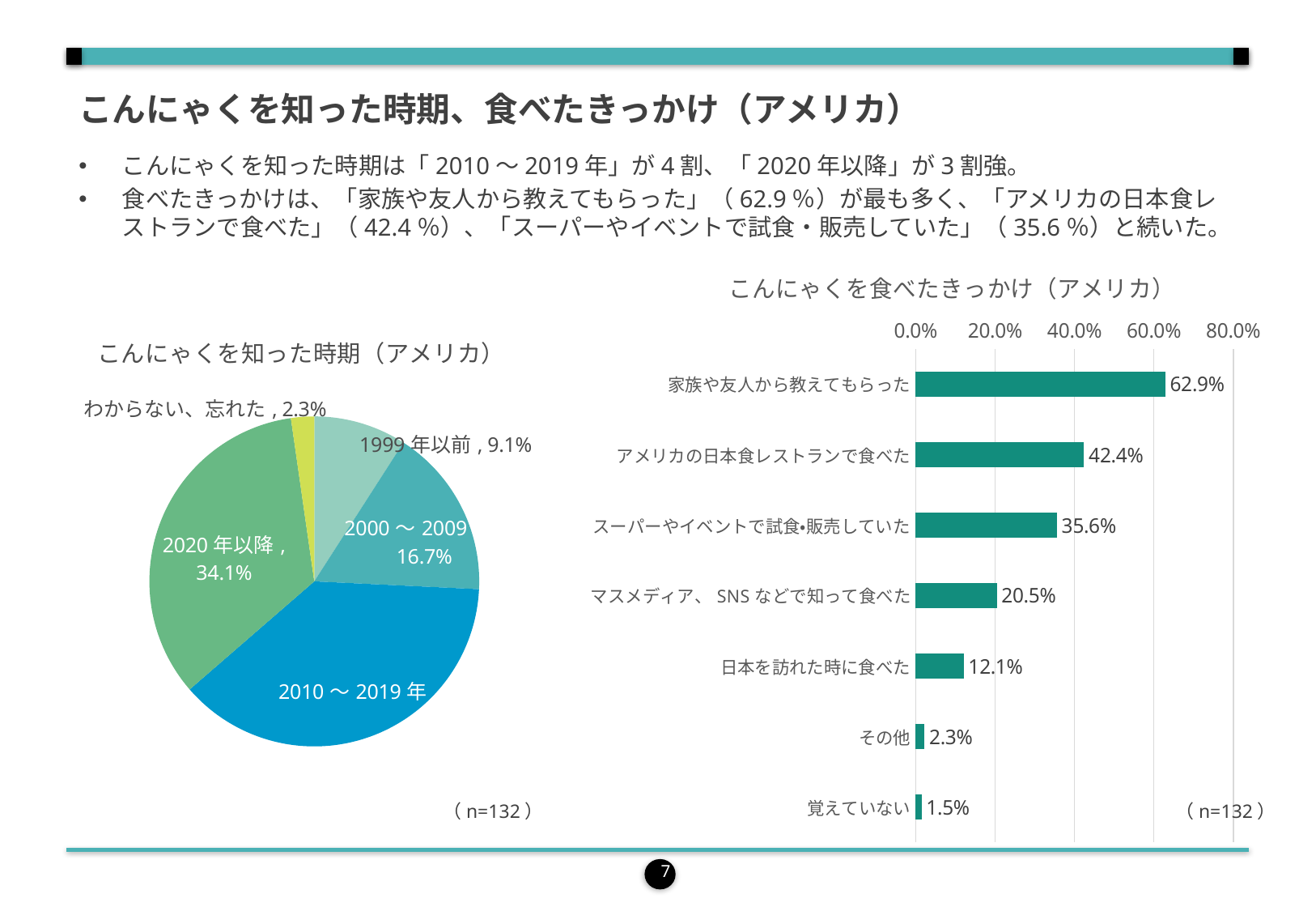
In the chart titled こんにゃくを食べたきっかけ（アメリカ）, which category has the lowest value? 覚えていない What kind of chart is the chart titled こんにゃくを知った時期（アメリカ）? pie chart In the chart titled こんにゃくを知った時期（アメリカ）, what is the value for 2000～2009? 16.7% What kind of chart is the chart titled こんにゃくを食べたきっかけ（アメリカ）? bar chart In the chart titled こんにゃくを食べたきっかけ（アメリカ）, which category has the highest value? 家族や友人から教えてもらった In the chart titled こんにゃくを食べたきっかけ（アメリカ）, what is the value for 家族や友人から教えてもらった? 62.9% In the chart titled こんにゃくを食べたきっかけ（アメリカ）, what is the value for スーパーやイベントで試食・販売していた? 35.6% In the chart titled こんにゃくを食べたきっかけ（アメリカ）, is the value for 家族や友人から教えてもらった greater or less than 60.0%? greater In the chart titled こんにゃくを食べたきっかけ（アメリカ）, how many categories are shown? 7 In the chart titled こんにゃくを知った時期（アメリカ）, what share does 2020年以降 have? 34.1% In the chart titled こんにゃくを知った時期（アメリカ）, which slice is the smallest? わからない、忘れた In the chart titled こんにゃくを食べたきっかけ（アメリカ）, what is the difference between 家族や友人から教えてもらった and アメリカの日本食レストランで食べた? 20.5%